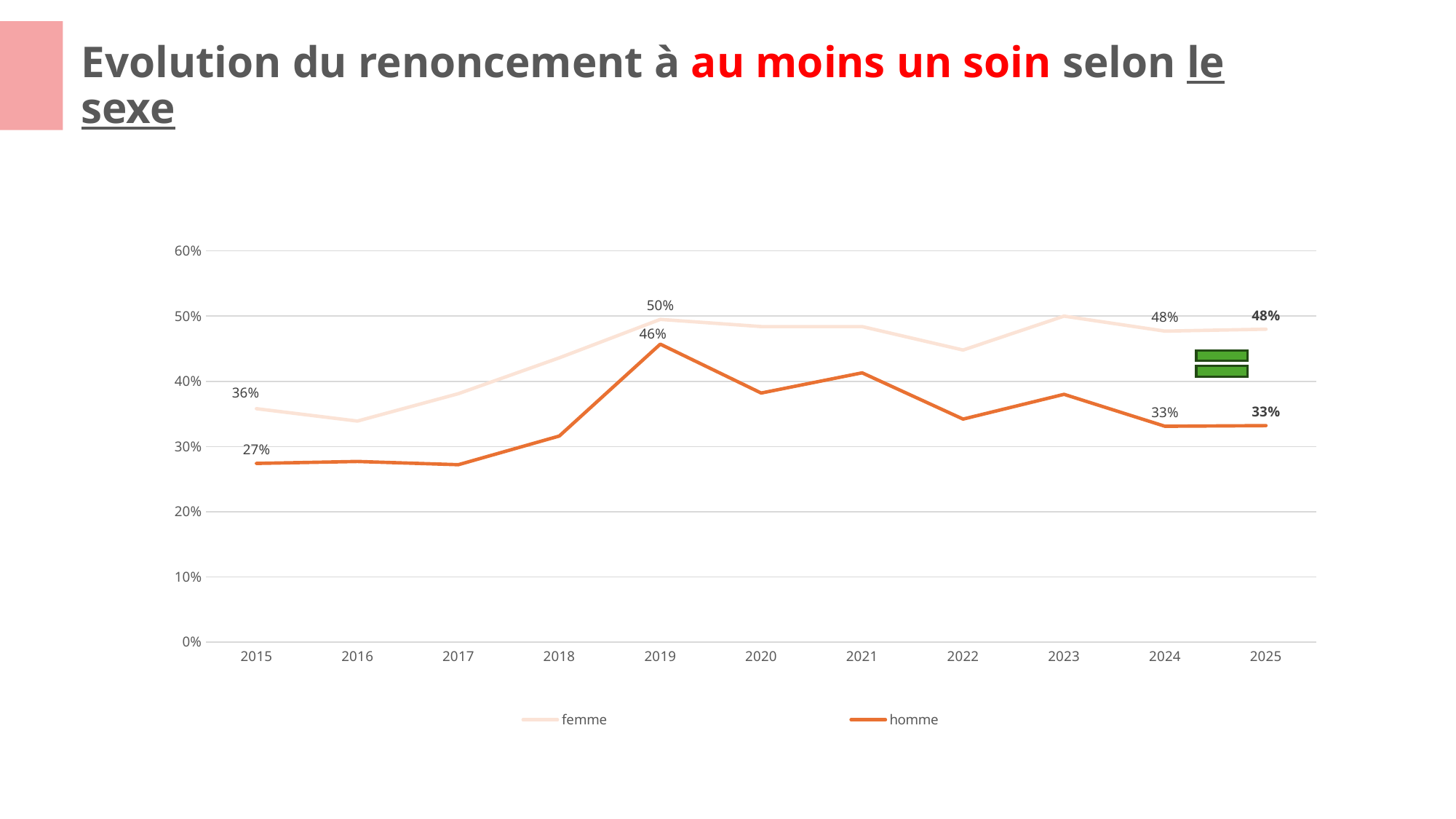
What is the difference between the femme and homme values in 2015? 9% How many series does the legend list? 2 How many years are shown on the x axis? 11 What is the value for femme in 2019? 50% What is the value for femme in 2024? 48% Which series has the higher value in 2019, femme or homme? femme Is the value for homme in 2017 greater or less than 30%? less Does the homme line rise or fall between 2015 and 2019? rise What is the value for homme in 2025? 33% What kind of chart is shown on the slide? line chart What is the value for homme in 2015? 27% What is the difference between the femme and homme values in 2025? 15%